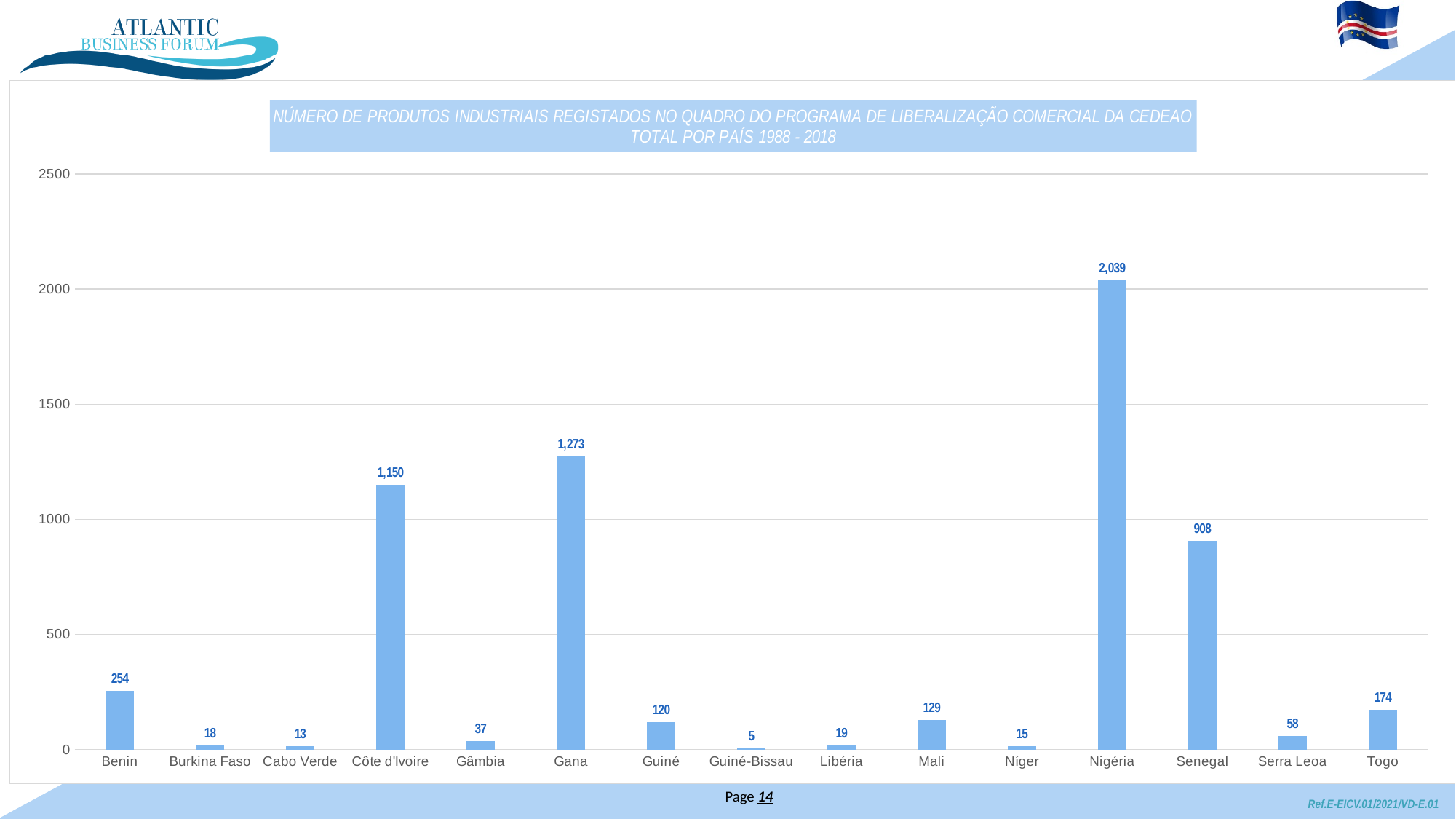
What is the value for Cabo Verde? 13 What is the difference between the values for Nigéria and Senegal? 1,131 What period does the chart title say the totals cover? 1988 - 2018 Which country has the lowest value? Guiné-Bissau What is the difference between the values for Gana and Côte d'Ivoire? 123 Which is larger, the value for Benin or the value for Togo? Benin Is the value for Senegal greater or less than 1000? less Which country has the highest value? Nigéria What kind of chart is shown on the slide? bar chart What is the value for Nigéria? 2,039 What is the value for Senegal? 908 How many countries are shown on the x axis? 15